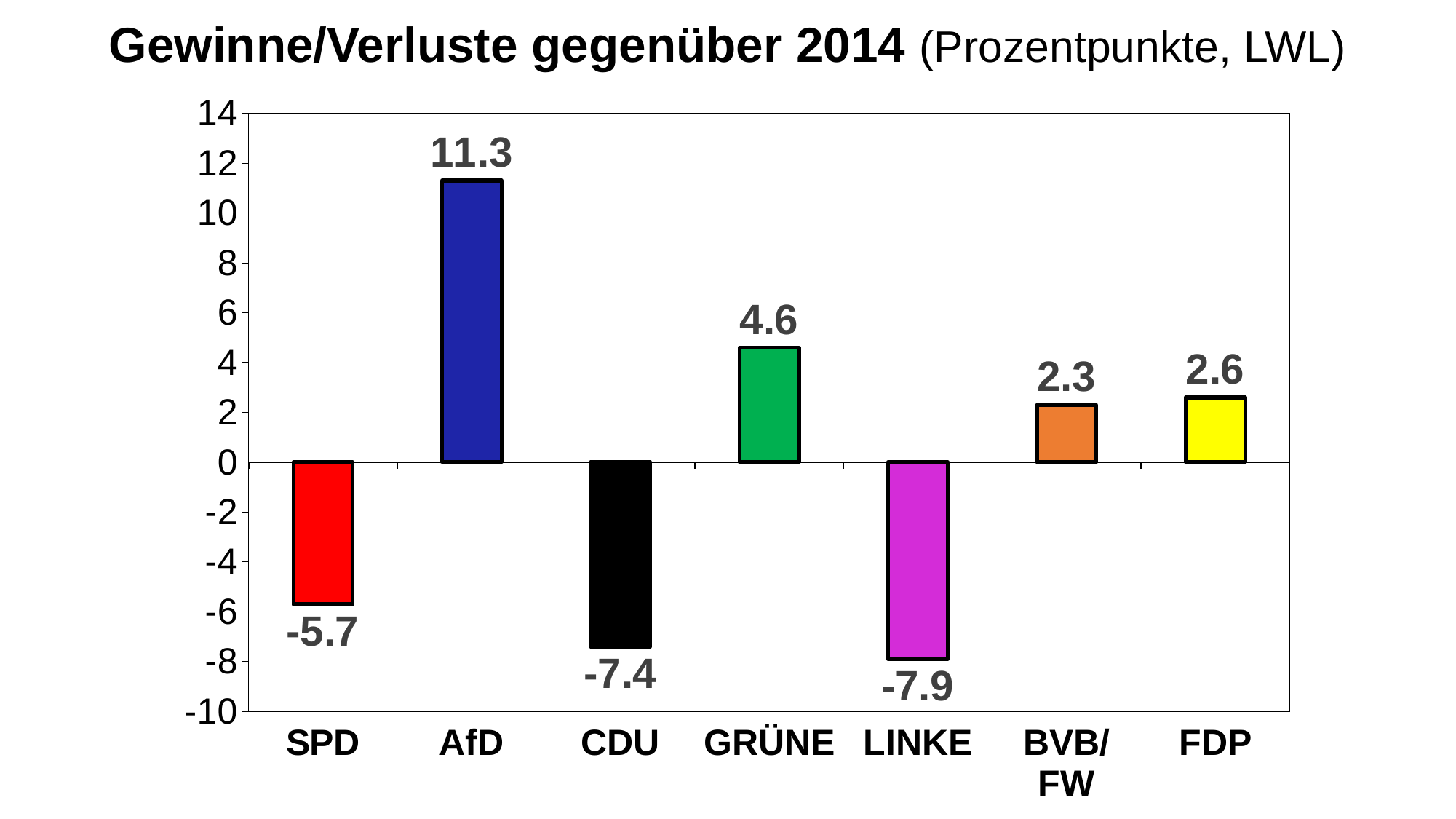
What is the value for AfD? 11.3 Is the value for SPD greater or less than -4? less Which party has the lowest value? LINKE What is the value for BVB/FW? 2.3 What is the value for CDU? -7.4 What colour is the bar for LINKE? magenta What kind of chart is this? bar chart Which has the larger value, FDP or BVB/FW? FDP What is the difference between the values for AfD and GRÜNE? 6.7 Which party has the highest value? AfD How many parties are shown on the x axis? 7 How many parties have a negative value? 3